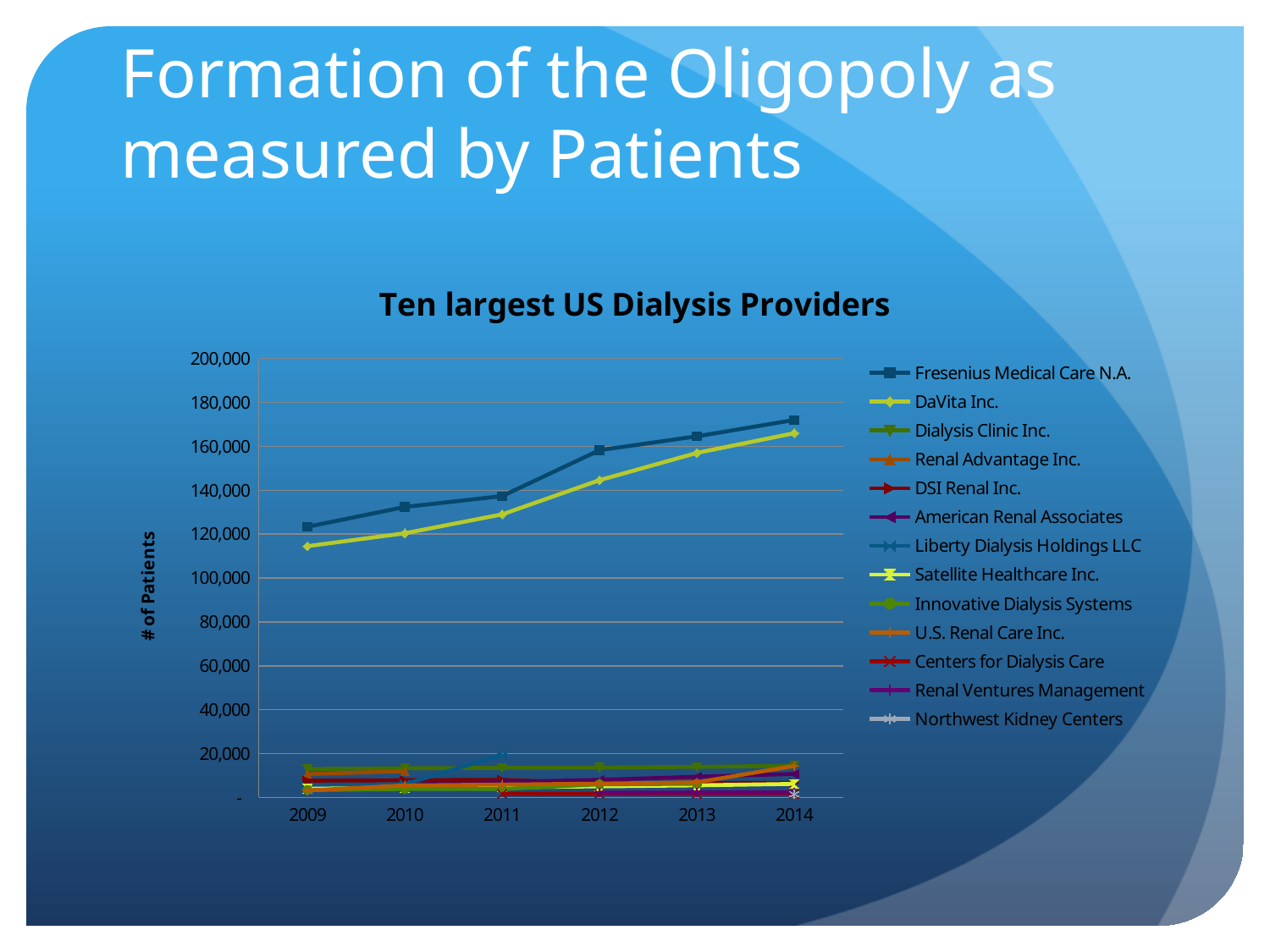
What is the label of the y axis? # of Patients Is the value for Fresenius Medical Care N.A. in 2014 greater or less than 160,000? greater How many series does the legend list? 13 Which is larger in 2014, the value for Fresenius Medical Care N.A. or the value for DaVita Inc.? Fresenius Medical Care N.A. Is the value for Fresenius Medical Care N.A. in 2012 greater or less than 140,000? greater Does the number of patients for DaVita Inc. rise or fall from 2009 to 2014? Rise What is the title of the chart? Ten largest US Dialysis Providers Does the number of patients for Fresenius Medical Care N.A. rise or fall from 2009 to 2014? Rise Which provider has the highest number of patients in 2014? Fresenius Medical Care N.A. Is the value for DaVita Inc. in 2009 greater or less than 120,000? less What kind of chart is shown on the slide? Line chart How many years are shown along the x axis? 6